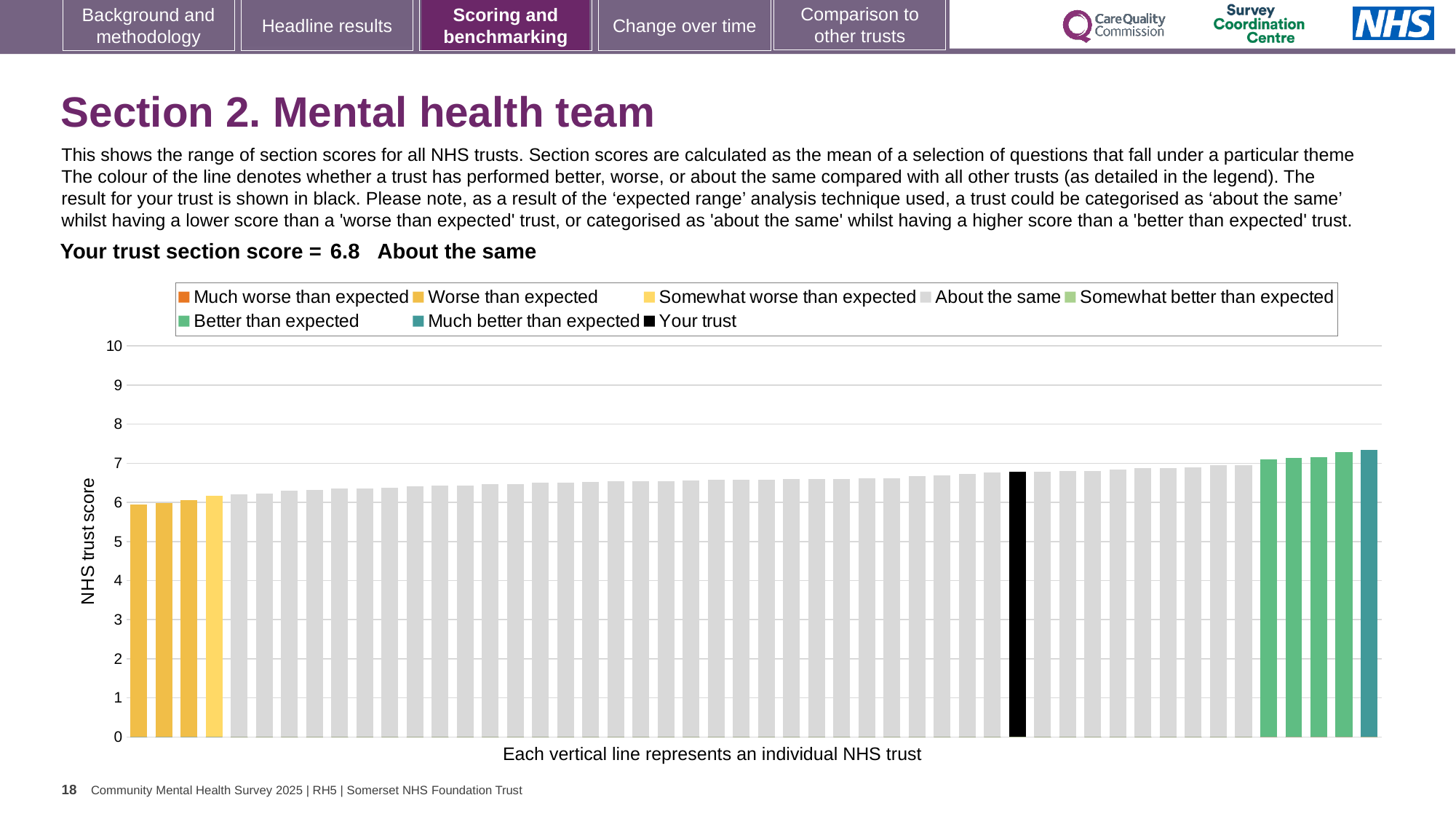
What is the section score for your trust shown on the slide? 6.8 Is the value of the black bar (your trust) greater or less than 5? greater How many entries does the chart legend list? 8 Is the value of the shortest bar greater or less than 4? greater What is the label on the vertical axis of the chart? NHS trust score Which category is your trust placed in for this section score? About the same Is the value of the shortest bar greater or less than 7? less What colour is the bar representing your trust? black What kind of chart is shown on the slide? bar chart Do the bar values rise or fall from left to right along the x axis? rise